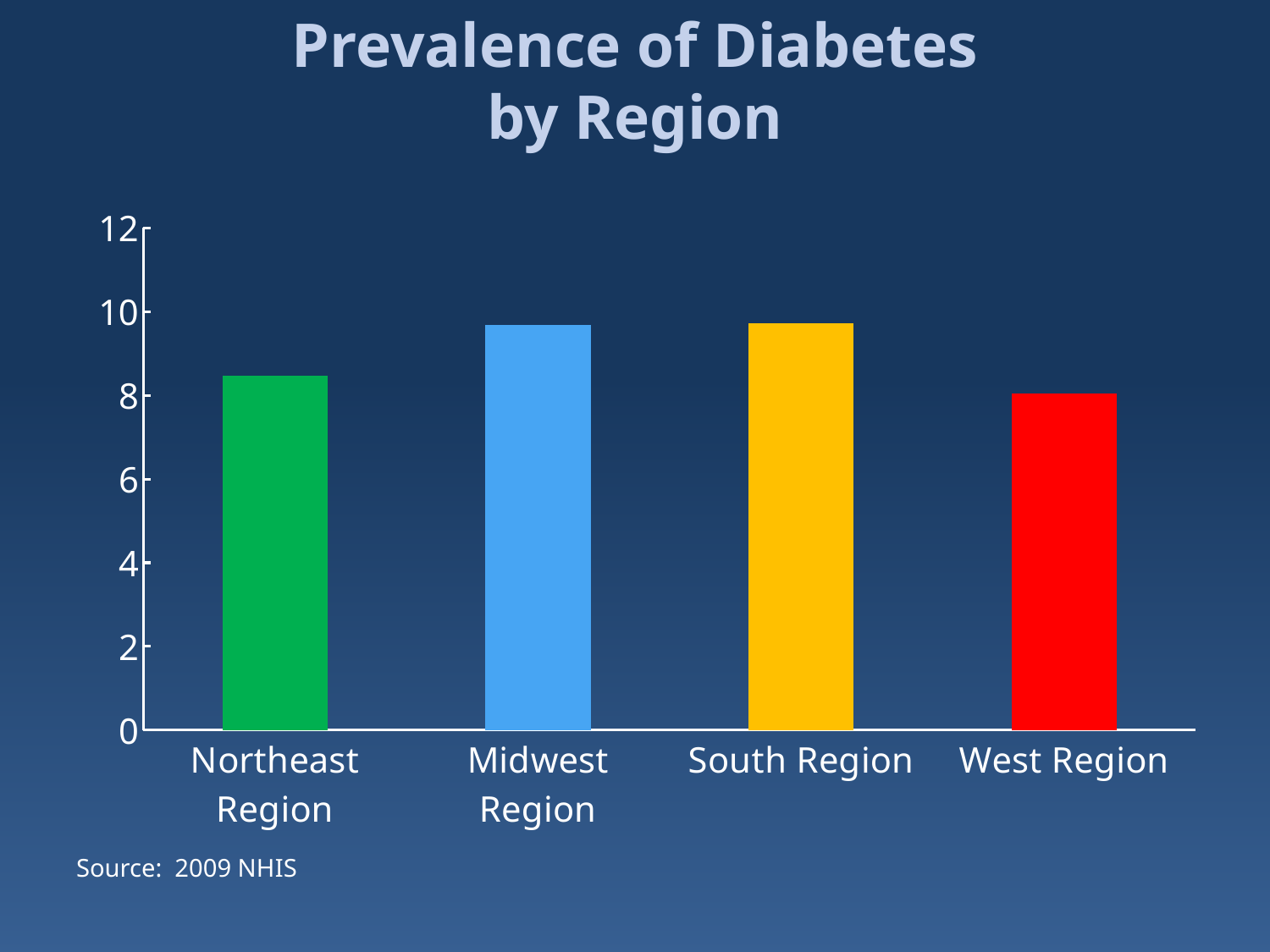
Which is larger, the value for Midwest Region or Northeast Region? Midwest Region Is the value for Midwest Region greater or less than 10? less Which region has the lowest prevalence of diabetes? West Region Is the value for West Region greater or less than 10? less How many regions are shown on the x axis of the chart? 4 What is the title of the chart? Prevalence of Diabetes by Region What kind of chart is shown on the slide? bar chart Is the value for South Region greater or less than 10? less What colour is the bar for West Region? red Which is larger, the value for South Region or West Region? South Region